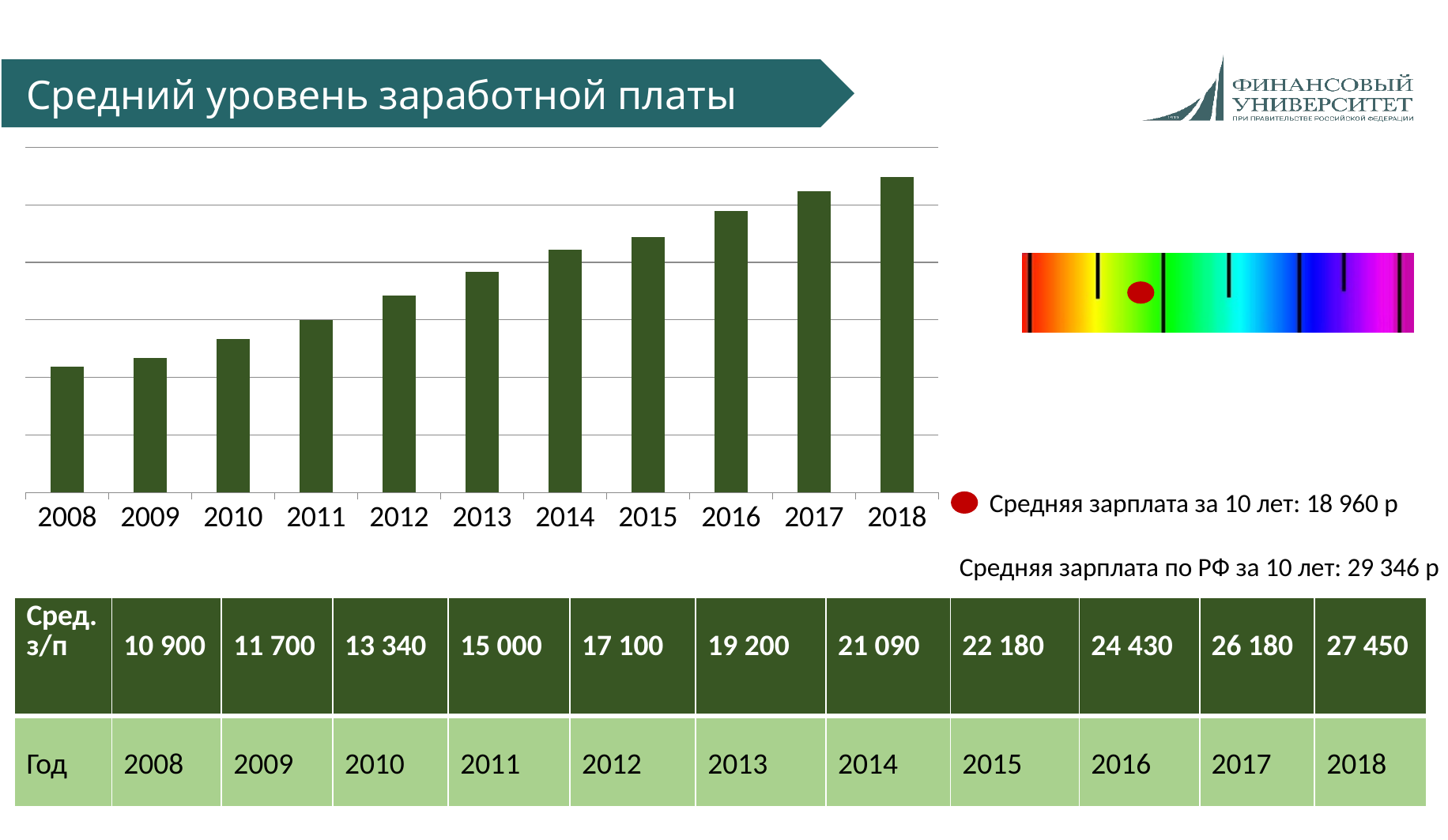
What is the difference between the values for 2018 and 2008? 16 550 What type of chart is shown on the slide? bar chart What is the difference between the values for 2013 and 2012? 2 100 Which is larger, the value for 2011 or the value for 2015? 2015 What is the average salary value for 2014? 21 090 Which year has the highest bar in the chart? 2018 What is the average salary value for 2018? 27 450 What is the average salary value for 2008? 10 900 Which year has the lowest bar in the chart? 2008 What is the title of the slide containing the chart? Средний уровень заработной платы How many years are plotted in the bar chart? 11 Do the bar values rise or fall from 2008 to 2018? rise